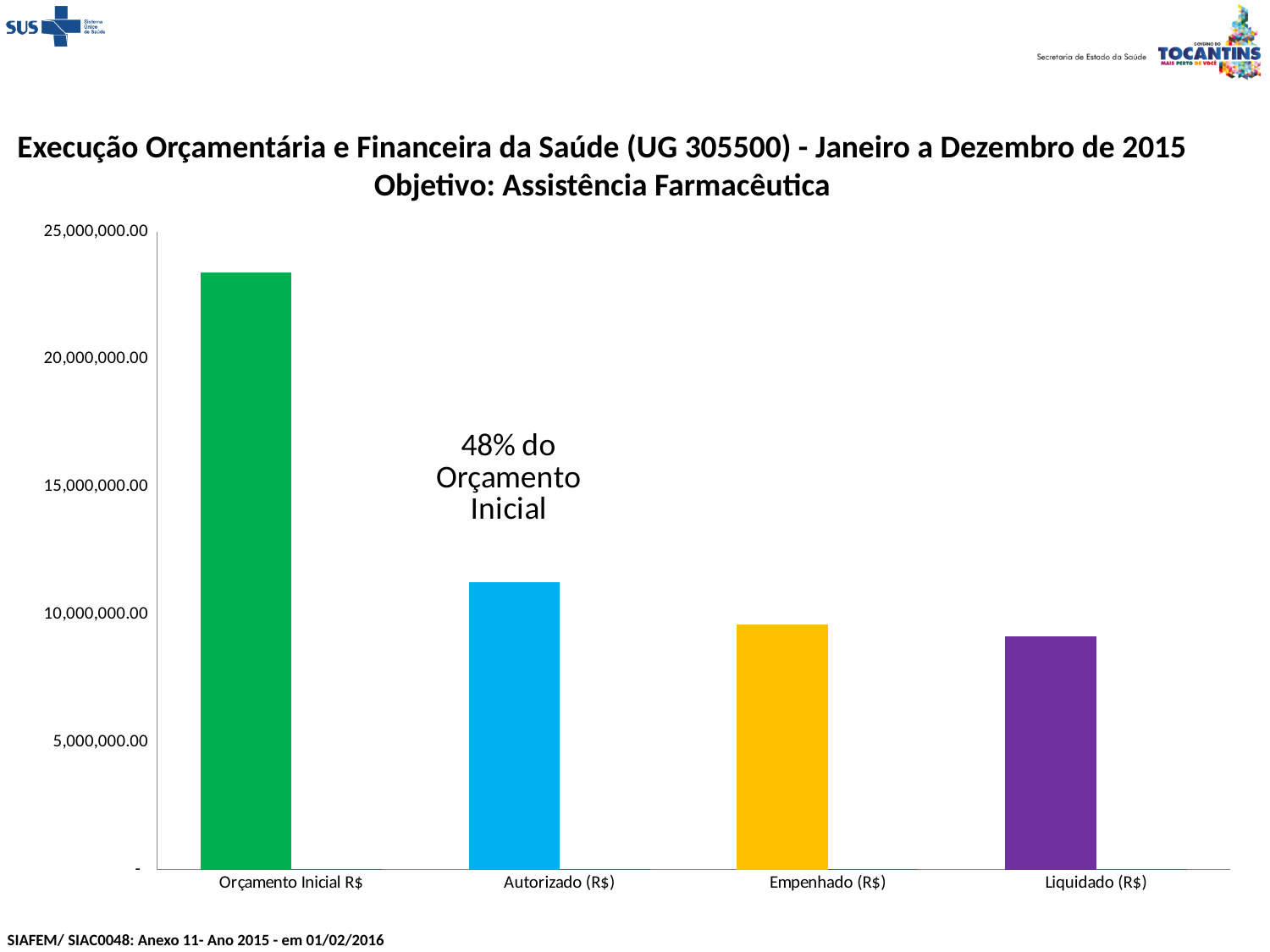
Is the value for Autorizado (R$) greater or less than 10,000,000.00? greater What does the text annotation placed above the Autorizado (R$) bar say? 48% do Orçamento Inicial Do the values rise or fall from left to right along the x axis? fall What kind of chart is shown on the slide? bar chart Which is larger, the value for Orçamento Inicial R$ or the value for Autorizado (R$)? Orçamento Inicial R$ Is the value for Liquidado (R$) greater or less than 5,000,000.00? greater Is the value for Autorizado (R$) greater or less than 15,000,000.00? less How many categories are plotted on the x axis? 4 Which category has the highest value? Orçamento Inicial R$